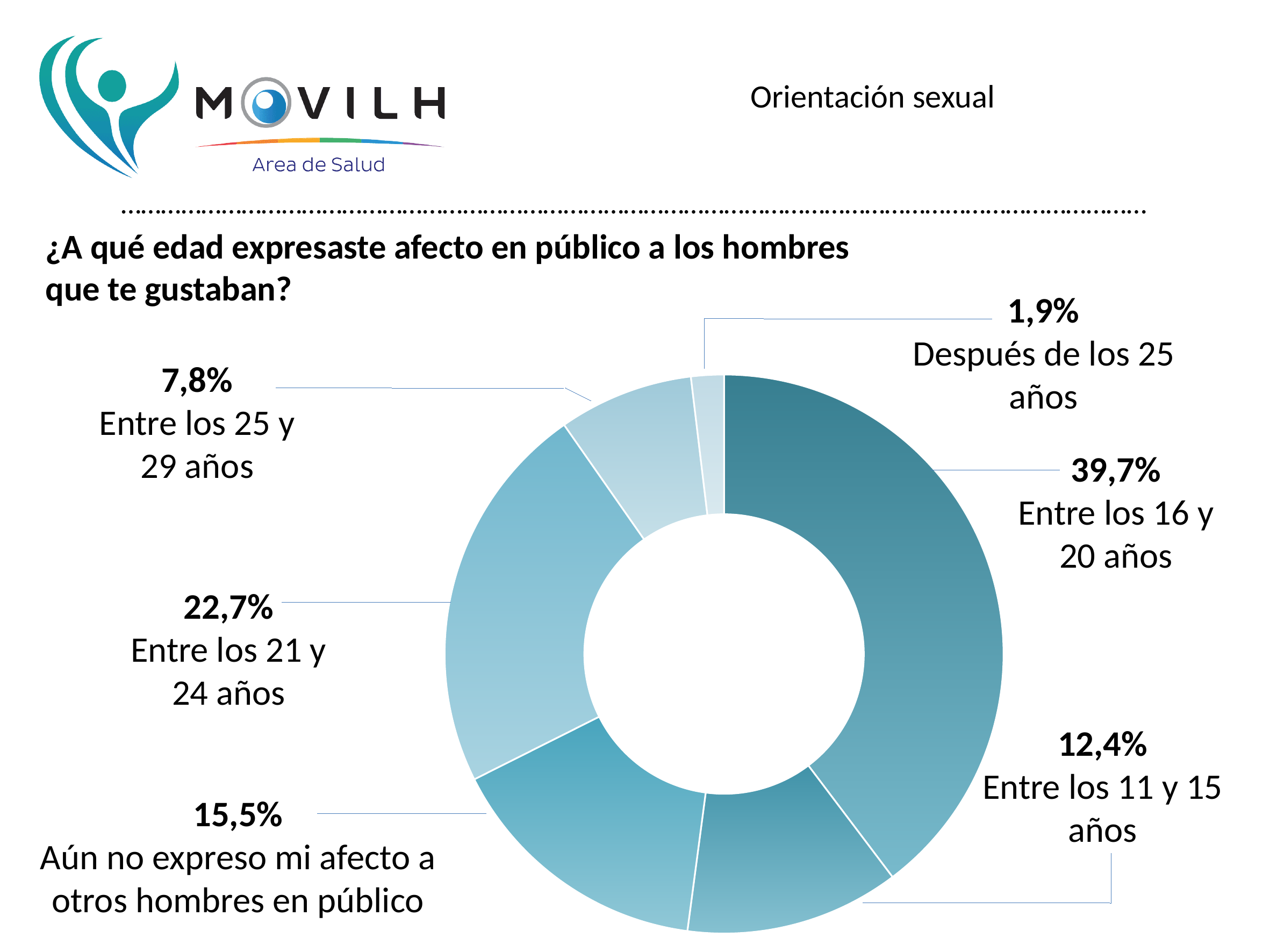
What percentage corresponds to 'Entre los 21 y 24 años'? 22,7% What percentage of respondents said 'Aún no expreso mi afecto a otros hombres en público'? 15,5% Which category has the smallest share of the chart? Después de los 25 años What is the difference in percentage points between 'Entre los 16 y 20 años' and 'Entre los 21 y 24 años'? 17 percentage points What kind of chart is shown on the slide? Doughnut chart Which is larger: the share for 'Entre los 11 y 15 años' or the share for 'Aún no expreso mi afecto a otros hombres en público'? Aún no expreso mi afecto a otros hombres en público What question does the chart answer, according to the title above it? ¿A qué edad expresaste afecto en público a los hombres que te gustaban? What percentage corresponds to 'Entre los 11 y 15 años'? 12,4% Which category has the largest share of the chart? Entre los 16 y 20 años What percentage corresponds to 'Después de los 25 años'? 1,9% How many categories are shown in the chart? 6 What percentage of respondents said they expressed affection in public between the ages of 16 and 20? 39,7%